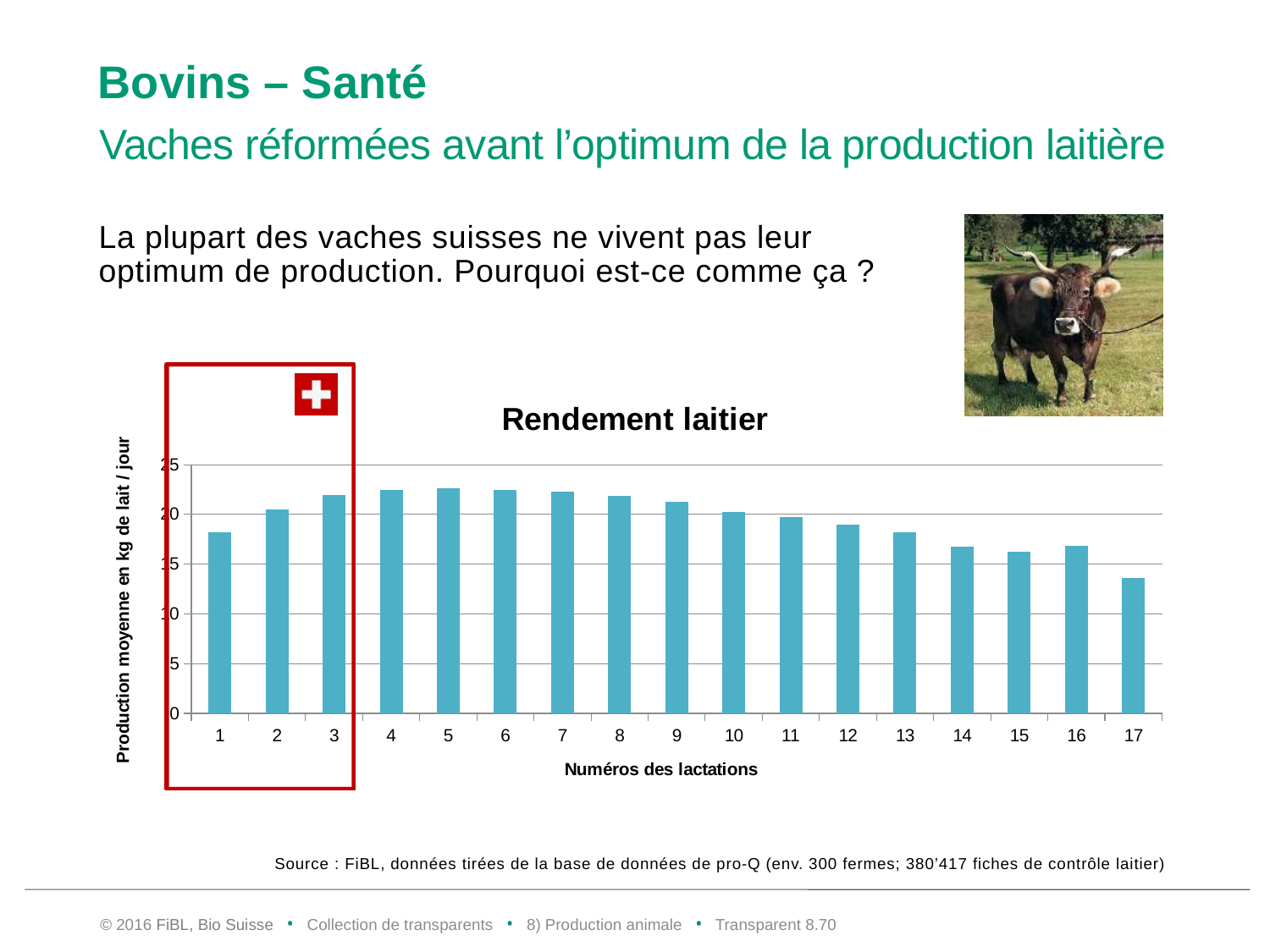
Is the value for lactation 17 greater or less than 15? less Which has a higher average milk production, lactation 1 or lactation 3? Lactation 3 Do the values rise or fall from lactation 8 to lactation 17? Fall What is the title of the chart? Rendement laitier Which lactation number has the lowest average milk production? 17 Is the value for lactation 14 greater or less than 20? less Which has a higher average milk production, lactation 2 or lactation 17? Lactation 2 How many lactation numbers are plotted on the x axis of the chart? 17 What is the label of the x axis of the chart? Numéros des lactations What kind of chart is shown on the slide? Bar chart Is the value for lactation 3 greater or less than 20? greater